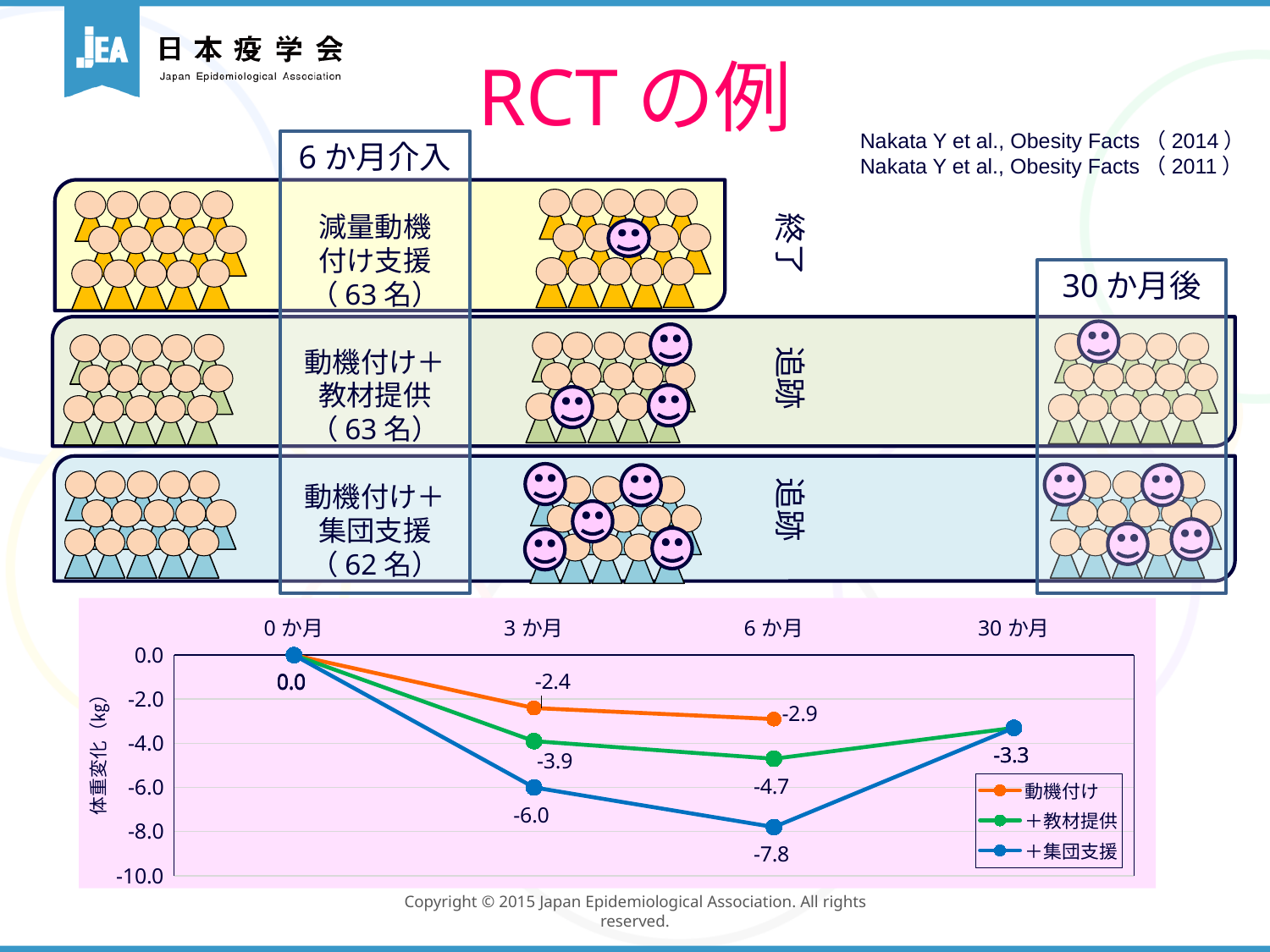
What is the weight change for the 動機付け series at 3 か月? -2.4 How many series does the legend of the weight-change chart list? 3 What is the difference between the 6 か月 values of the ＋集団支援 series (-7.8) and the 動機付け series (-2.9)? 4.9 What is the weight change for the ＋集団支援 series at 3 か月? -6.0 What is the weight change for the ＋教材提供 series at 3 か月? -3.9 How many time points are labelled along the x axis of the weight-change chart? 4 Which series shows the largest weight loss at 6 か月? ＋集団支援 At 3 か月, which series has a larger weight loss: ＋教材提供 or 動機付け? ＋教材提供 What is the weight change for the ＋集団支援 series at 6 か月? -7.8 What is the weight change for the 動機付け series at 6 か月? -2.9 What is the label on the y axis of the weight-change chart? 体重変化（kg） What type of chart is shown at the bottom of the slide? line chart